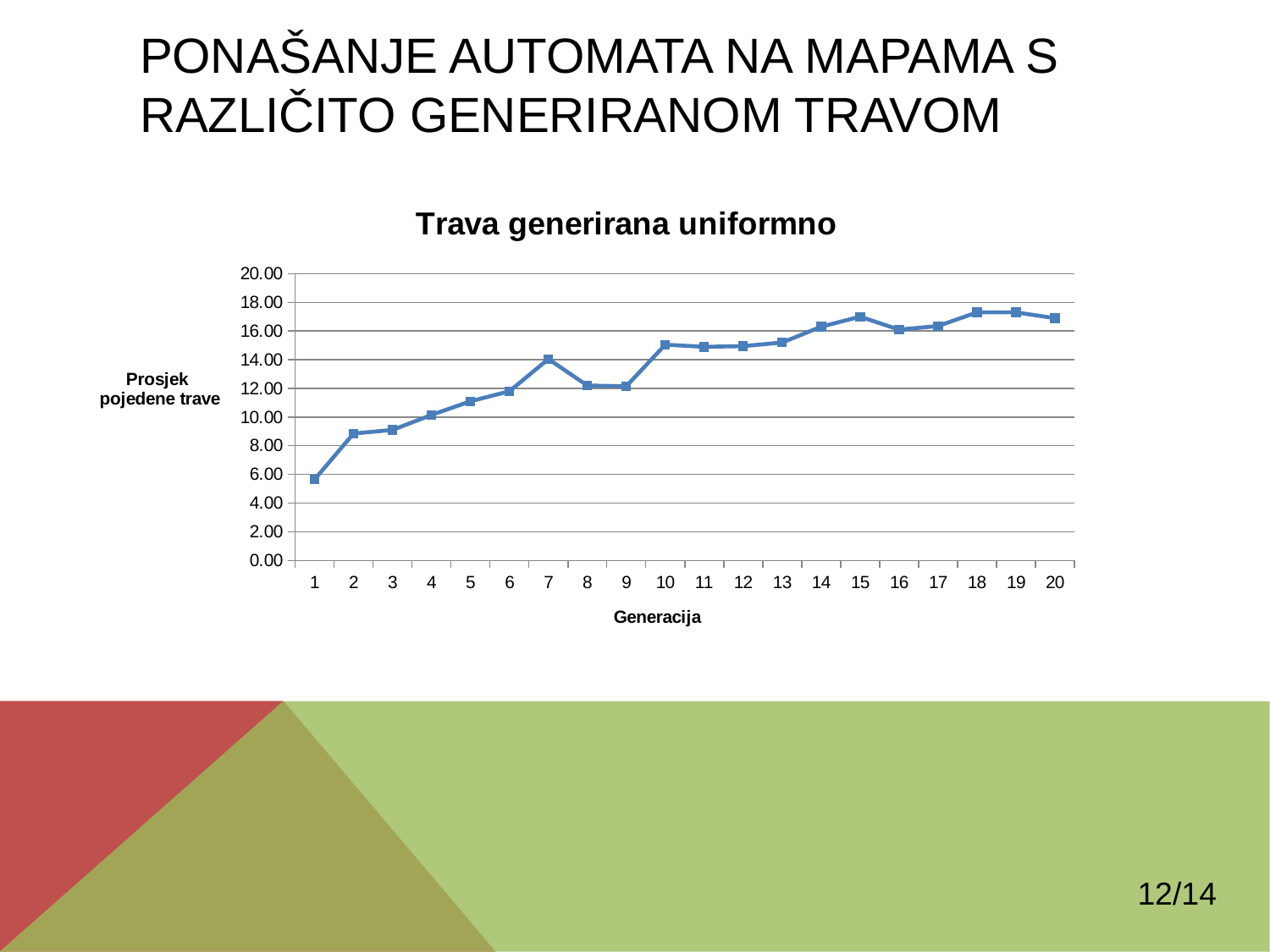
What kind of chart is shown on the slide? line chart What is the label of the x axis? Generacija Is the value for generation 1 greater or less than 8.00? less Do the values generally rise or fall as the generation increases? rise Is the value for generation 15 greater or less than 16.00? greater Which generation has the lowest value of Prosjek pojedene trave? 1 Which has the larger value, generation 7 or generation 8? generation 7 Is the value for generation 7 greater or less than 12.00? greater What is the title of the chart? Trava generirana uniformno Which has the larger value, generation 5 or generation 14? generation 14 How many generations are plotted on the x axis? 20